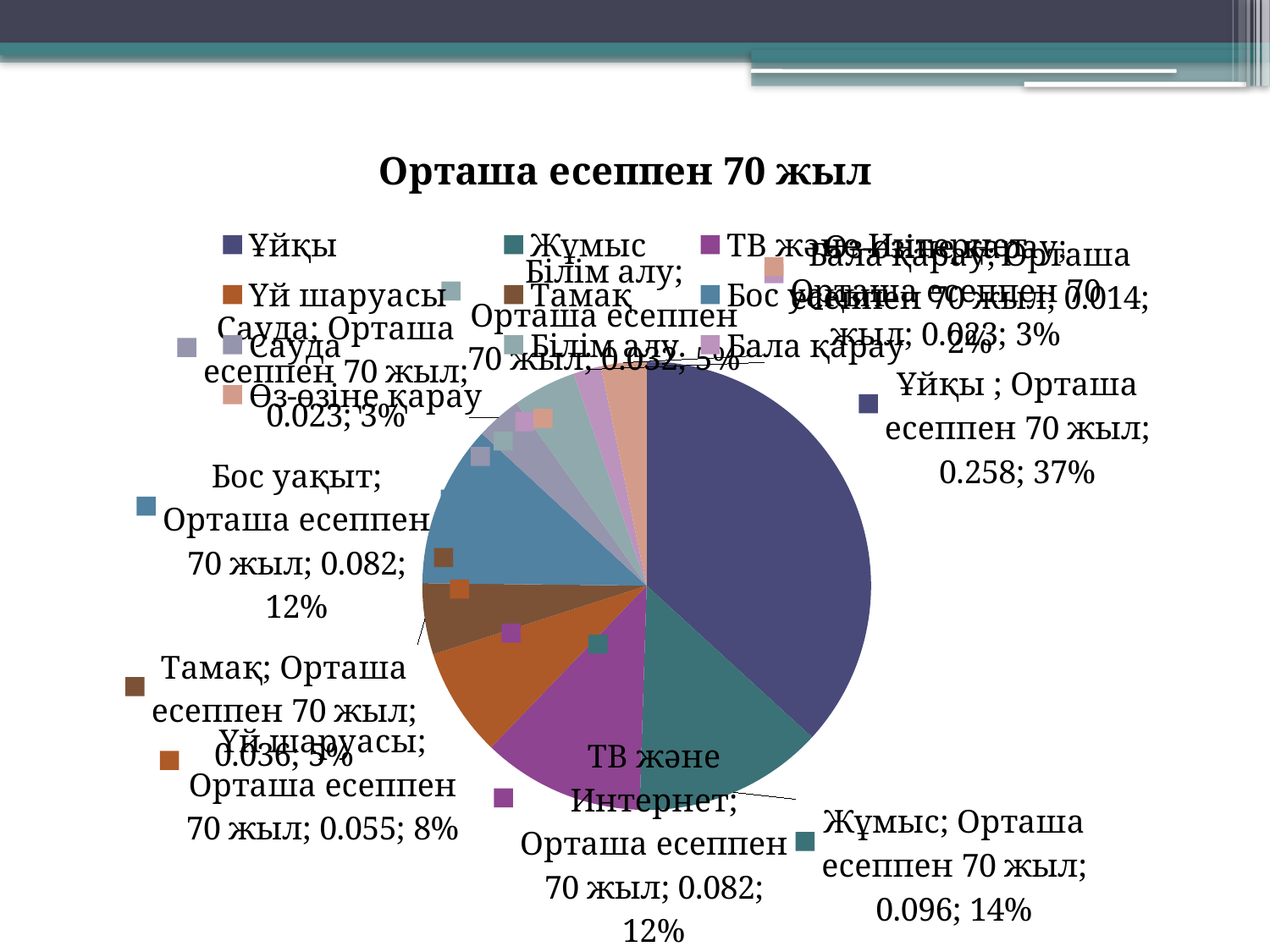
What is the difference between the values for Ұйқы and Жұмыс? 0.162 What is the value shown for ТВ және Интернет? 0.082 What is the title of the chart? Орташа есеппен 70 жыл What share of the pie does Үй шаруасы represent? 8% What is the difference between the values for Жұмыс and ТВ және Интернет? 0.014 What share of the pie does Бос уақыт represent? 12% Which category has the largest slice of the pie? Ұйқы What is the value shown for Жұмыс? 0.096 Which is larger, the value for Жұмыс or the value for Үй шаруасы? Жұмыс What is the value shown for Тамақ? 0.036 What kind of chart is shown on the slide? pie chart What share of the pie does the Ұйқы slice represent? 37%